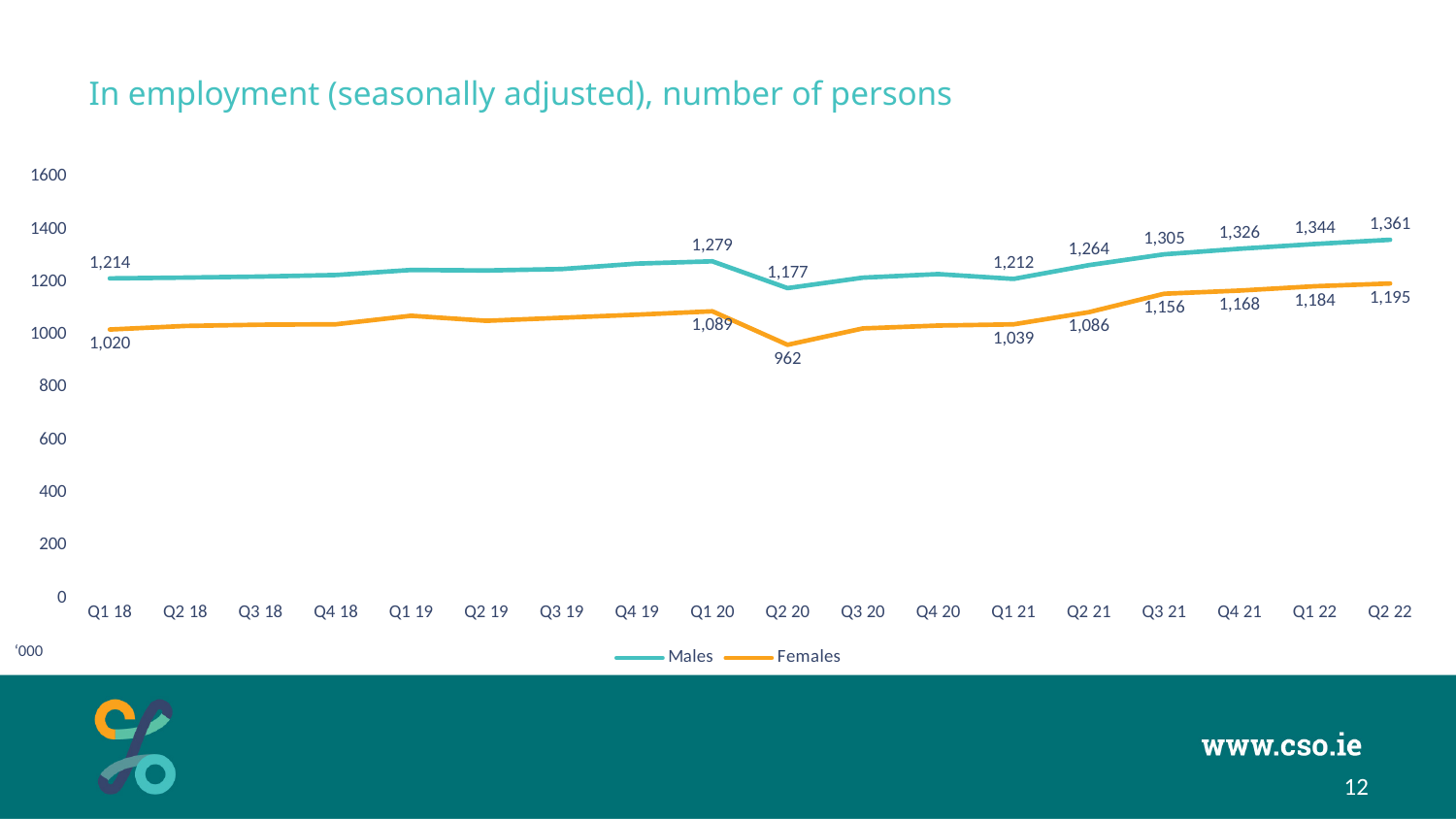
What is the value for Males in Q1 18? 1,214 What kind of chart is shown on the slide? line chart What is the value for Males in Q2 22? 1,361 Is the value for Males in Q4 20 greater or less than 1400? less By how much did the Males value fall from Q1 20 to Q2 20? 102 Which is larger, the Males value in Q1 20 or in Q2 20? Q1 20 How many series does the legend list? 2 What is the difference between the Males and Females values in Q2 22? 166 In which quarter is the Males value highest? Q2 22 In which quarter is the Females value lowest? Q2 20 How many quarters are shown on the x axis? 18 What is the value for Females in Q2 20? 962